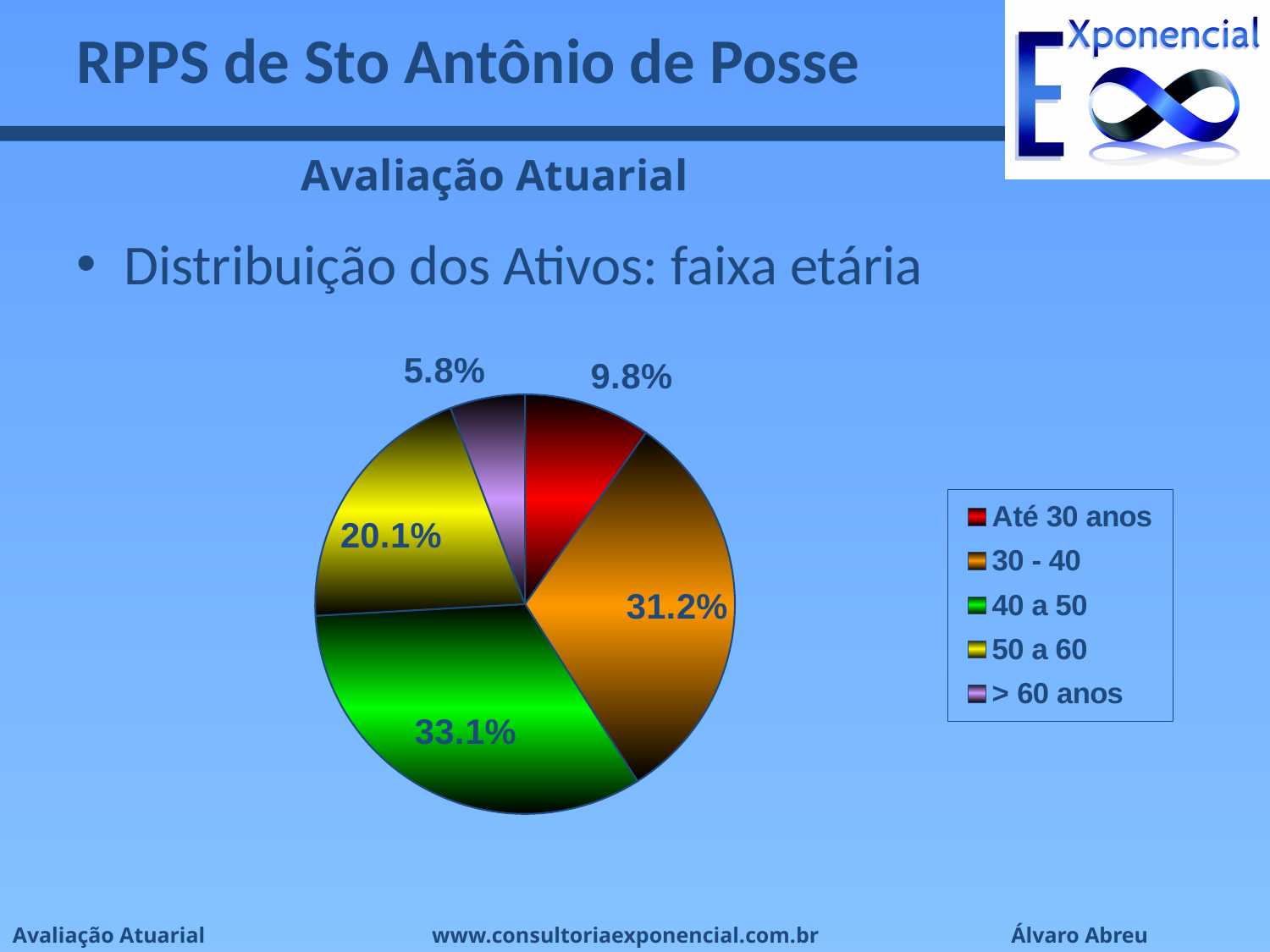
What share of the pie does the "Até 30 anos" age group have? 9.8% What share of the pie does the "50 a 60" age group have? 20.1% What kind of chart is shown on the slide? pie chart What share of the pie does the "> 60 anos" age group have? 5.8% How many age groups does the legend list? 5 What is the difference in percentage points between the "40 a 50" and "30 - 40" shares? 1.9 What share of the pie does the "40 a 50" age group have? 33.1% Which age group has the smallest share of the pie? > 60 anos What share of the pie does the "30 - 40" age group have? 31.2% Which has a larger share, "50 a 60" or "Até 30 anos"? 50 a 60 Which age group has the largest share of the pie? 40 a 50 What colour is the slice for "30 - 40"? orange